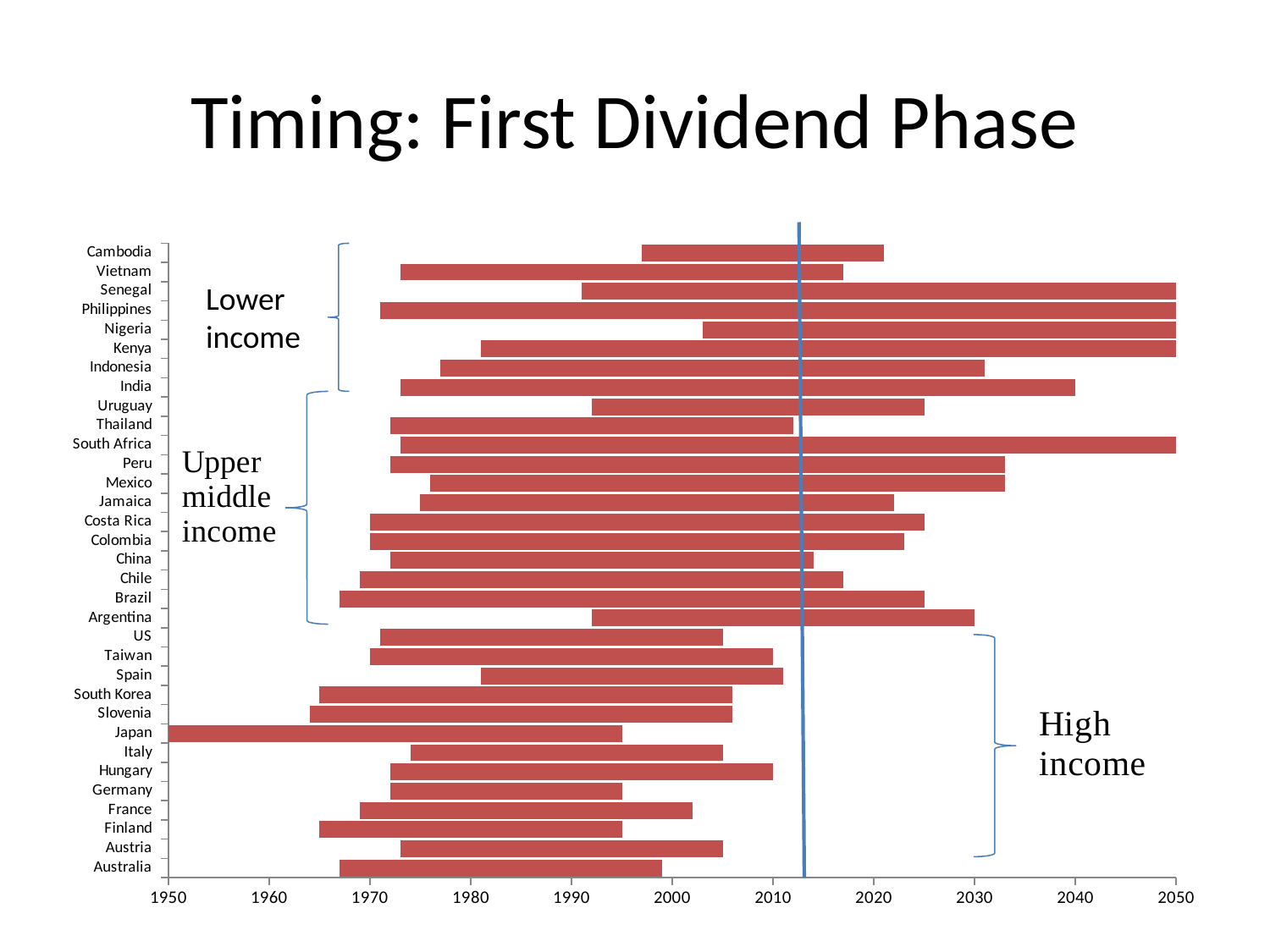
How many income groups are labelled with brackets on the chart? 3 Is the start year of the bar for Brazil greater or less than 1970? less Is the end year of the bar for Germany greater or less than 2000? less How many countries are listed on the vertical axis of the chart? 33 What kind of chart is shown on the slide? bar chart In what year does the bar for Japan begin? 1950 Which country's bar extends furthest to the left on the chart? Japan What is the title of the slide? Timing: First Dividend Phase Which bar is longer, Japan or Cambodia? Japan In what year does the bar for Senegal end? 2050 Which bar ends later, Indonesia or India? India Is the end year of the bar for India greater or less than 2030? greater